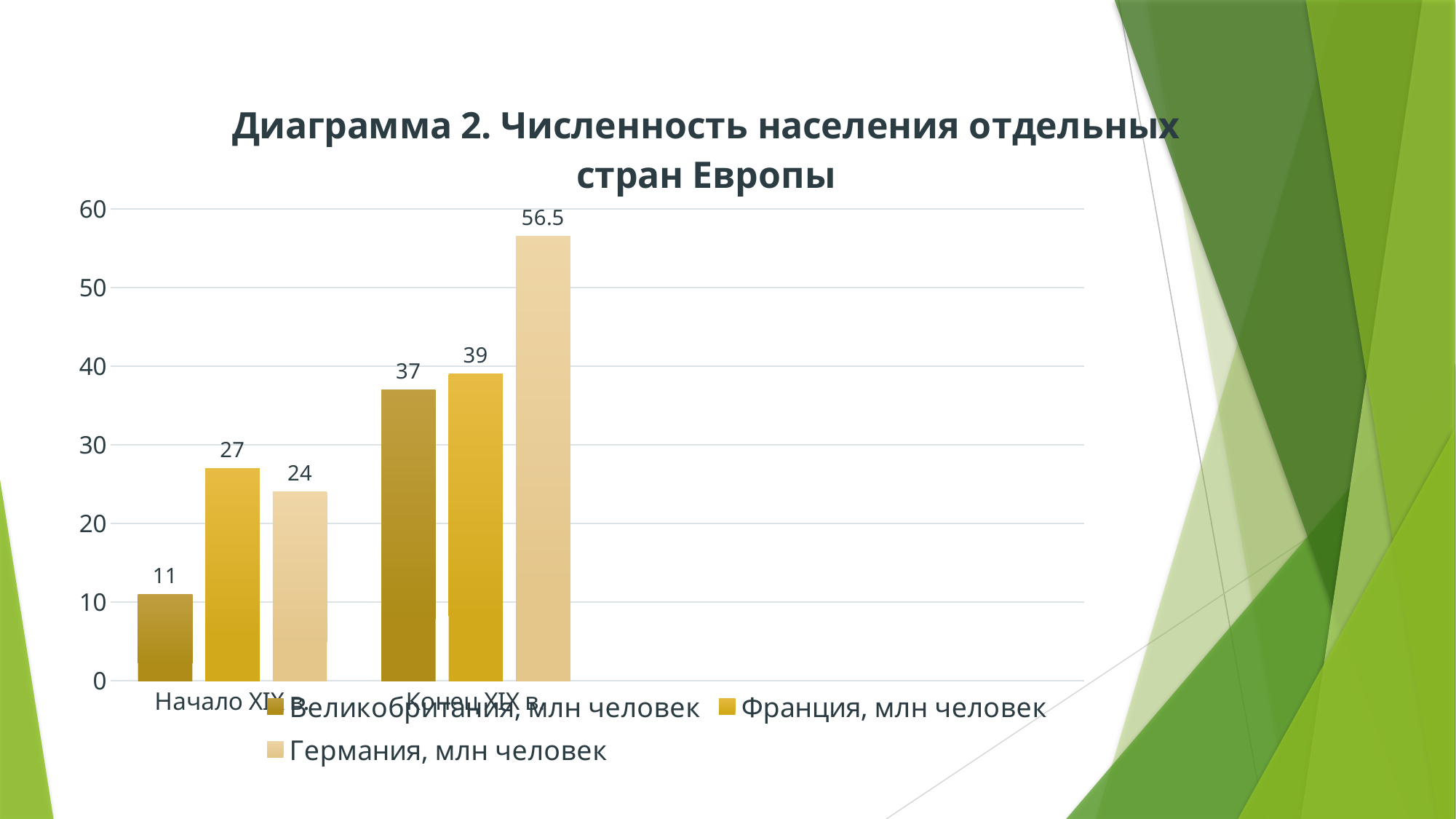
How many series does the legend list? 3 Is the value for Великобритания, млн человек at Конец XIX в. greater or less than 30? greater What is the value for Великобритания, млн человек at Начало XIX в.? 11 What is the value for Германия, млн человек at Конец XIX в.? 56.5 What is the value for Франция, млн человек at Начало XIX в.? 27 What is the difference between the values for Германия, млн человек at Конец XIX в. and Начало XIX в.? 32.5 Which series has the lowest value at Начало XIX в.? Великобритания, млн человек Which series has the highest value at Конец XIX в.? Германия, млн человек How many categories are shown on the x axis? 2 Do the values for Франция, млн человек rise or fall from Начало XIX в. to Конец XIX в.? rise Which is larger at Начало XIX в.: Франция, млн человек or Германия, млн человек? Франция, млн человек What kind of chart is shown on the slide? bar chart